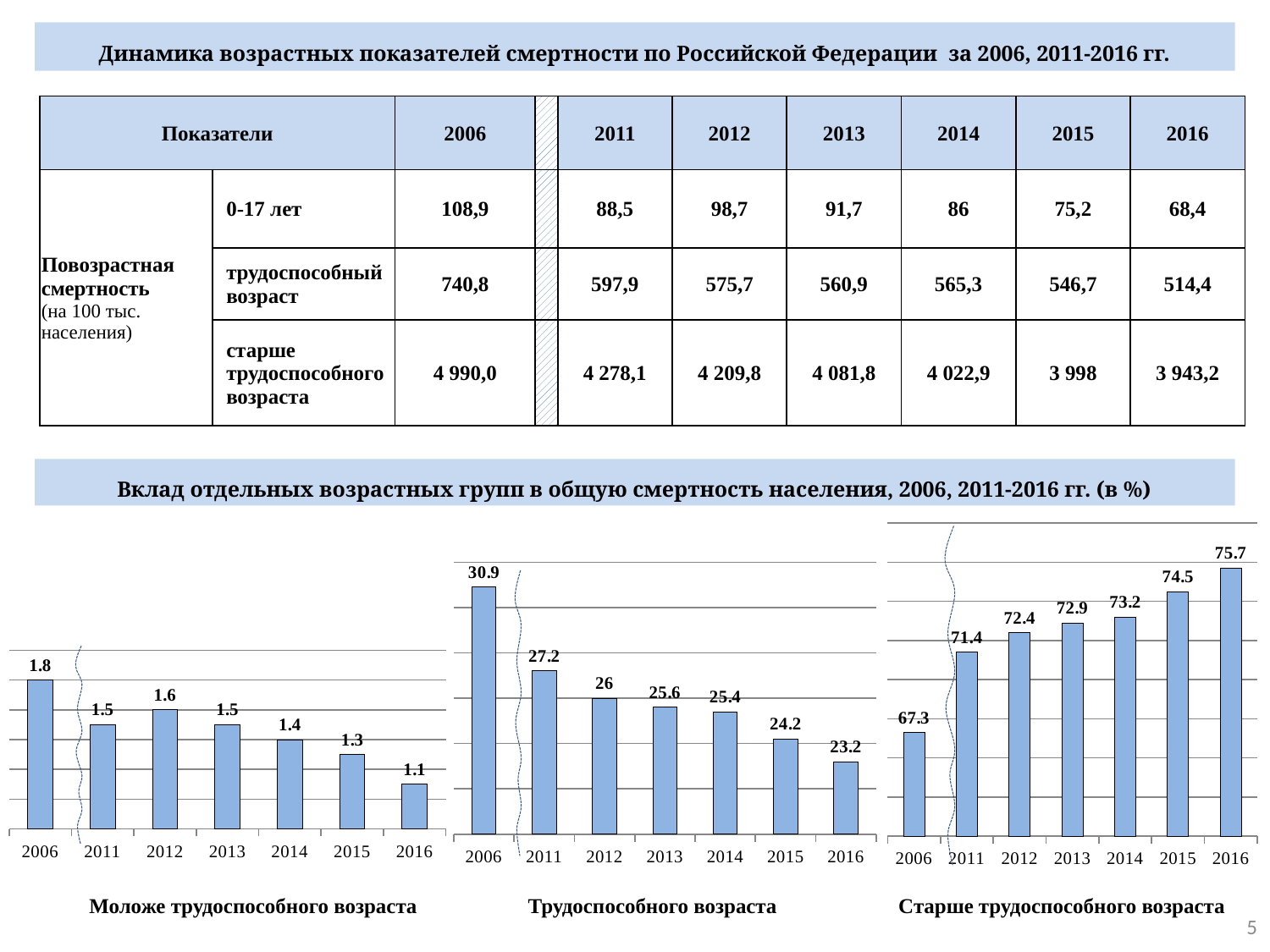
In the chart titled «Трудоспособного возраста», what is the difference between the values for 2006 and 2016? 7.7 In the chart titled «Моложе трудоспособного возраста», what is the value for 2006? 1.8 In the chart titled «Старше трудоспособного возраста», do the values rise or fall from 2006 to 2016? Rise In the chart titled «Трудоспособного возраста», which year has the lowest value? 2016 In the chart titled «Старше трудоспособного возраста», which year has the highest value? 2016 What type of chart is used for «Старше трудоспособного возраста»? Bar chart In the chart titled «Старше трудоспособного возраста», what is the difference between the values for 2016 and 2006? 8.4 In the chart titled «Моложе трудоспособного возраста», which is larger: the value for 2012 or the value for 2015? 2012 In the chart titled «Моложе трудоспособного возраста», which year has the highest value? 2006 In the chart titled «Трудоспособного возраста», what is the value for 2014? 25.4 How many years (bars) are shown in the chart titled «Трудоспособного возраста»? 7 In the chart titled «Старше трудоспособного возраста», what is the value for 2013? 72.9